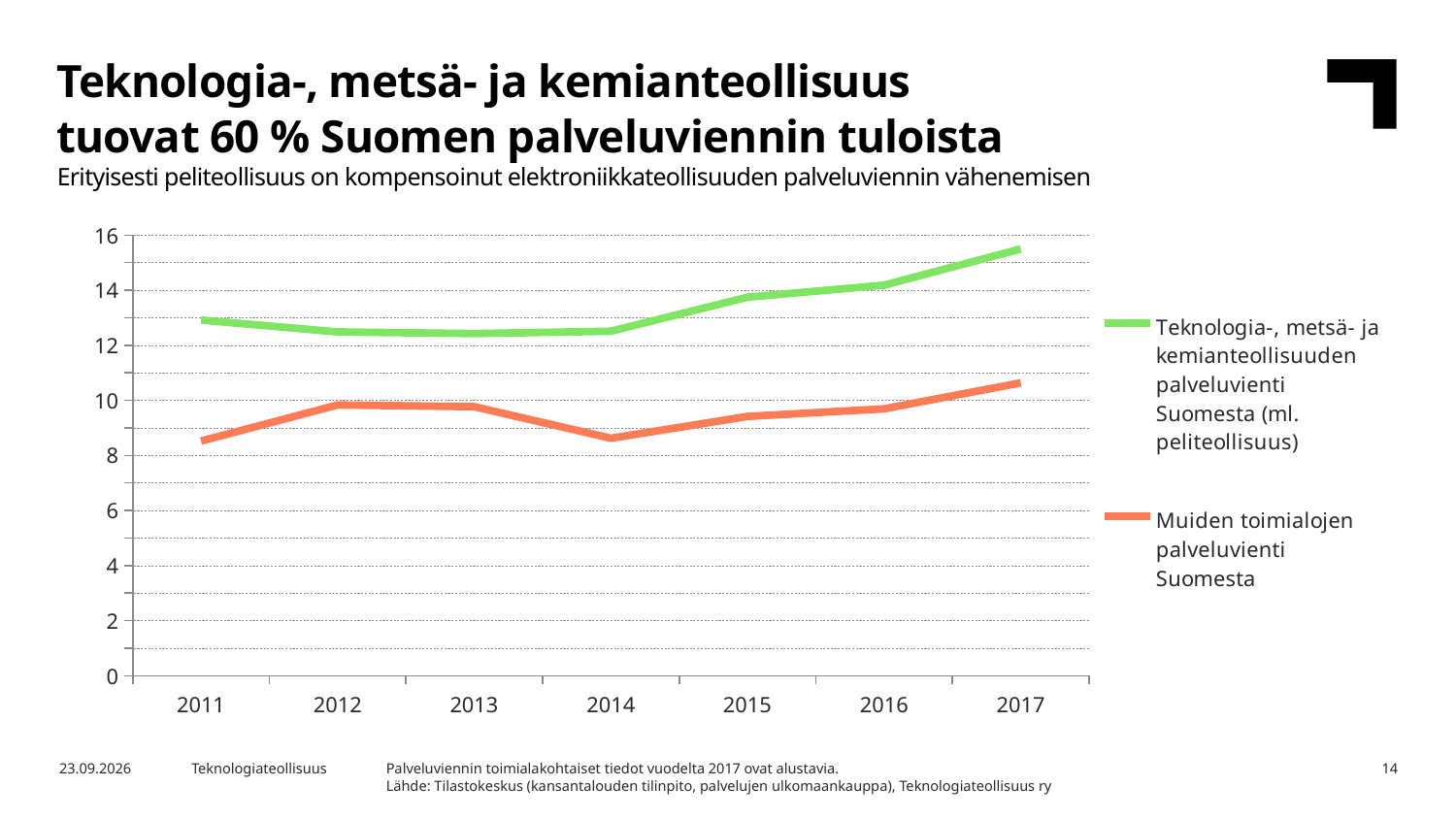
Is the value for Muiden toimialojen palveluvienti Suomesta in 2017 greater or less than 10? greater How many series does the legend list? 2 In which year is the value for Teknologia-, metsä- ja kemianteollisuuden palveluvienti Suomesta highest? 2017 Is the value for Teknologia-, metsä- ja kemianteollisuuden palveluvienti Suomesta in 2017 greater or less than 14? greater Does the value for Teknologia-, metsä- ja kemianteollisuuden palveluvienti Suomesta rise or fall from 2014 to 2017? rise What kind of chart is shown on the slide? Line chart Which series has the larger value in 2015: Teknologia-, metsä- ja kemianteollisuuden palveluvienti Suomesta or Muiden toimialojen palveluvienti Suomesta? Teknologia-, metsä- ja kemianteollisuuden palveluvienti Suomesta What colour is the line for Muiden toimialojen palveluvienti Suomesta? Orange In which year is the value for Muiden toimialojen palveluvienti Suomesta highest? 2017 Is the value for Muiden toimialojen palveluvienti Suomesta in 2011 greater or less than 10? less How many years are plotted along the x axis? 7